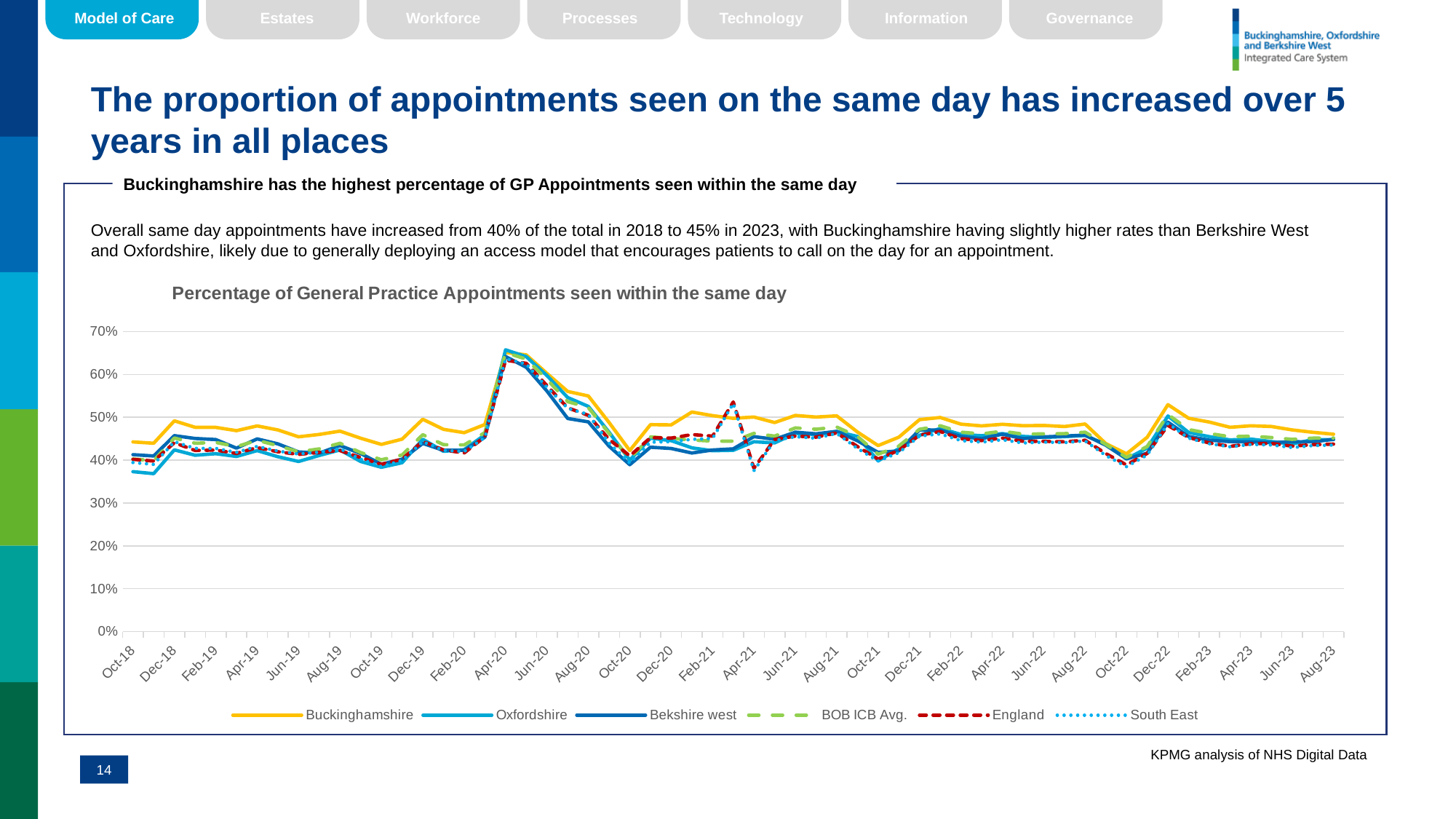
Which series has the lowest value in Oct-18? Oxfordshire Is the value for Oxfordshire in Oct-18 greater or less than 40%? less In Oct-18, which is larger: the value for Buckinghamshire or the value for Oxfordshire? Buckinghamshire Is the value for Buckinghamshire in Oct-18 greater or less than 40%? greater Is the value for Buckinghamshire in Oct-20 greater or less than 50%? less What kind of chart is shown on the slide? Line chart Which series is generally the highest across the chart? Buckinghamshire What is the highest value shown on the y axis? 70% What is the title of the chart? Percentage of General Practice Appointments seen within the same day How many series does the chart legend list? 6 Which series is shown with a red dashed line in the chart? England